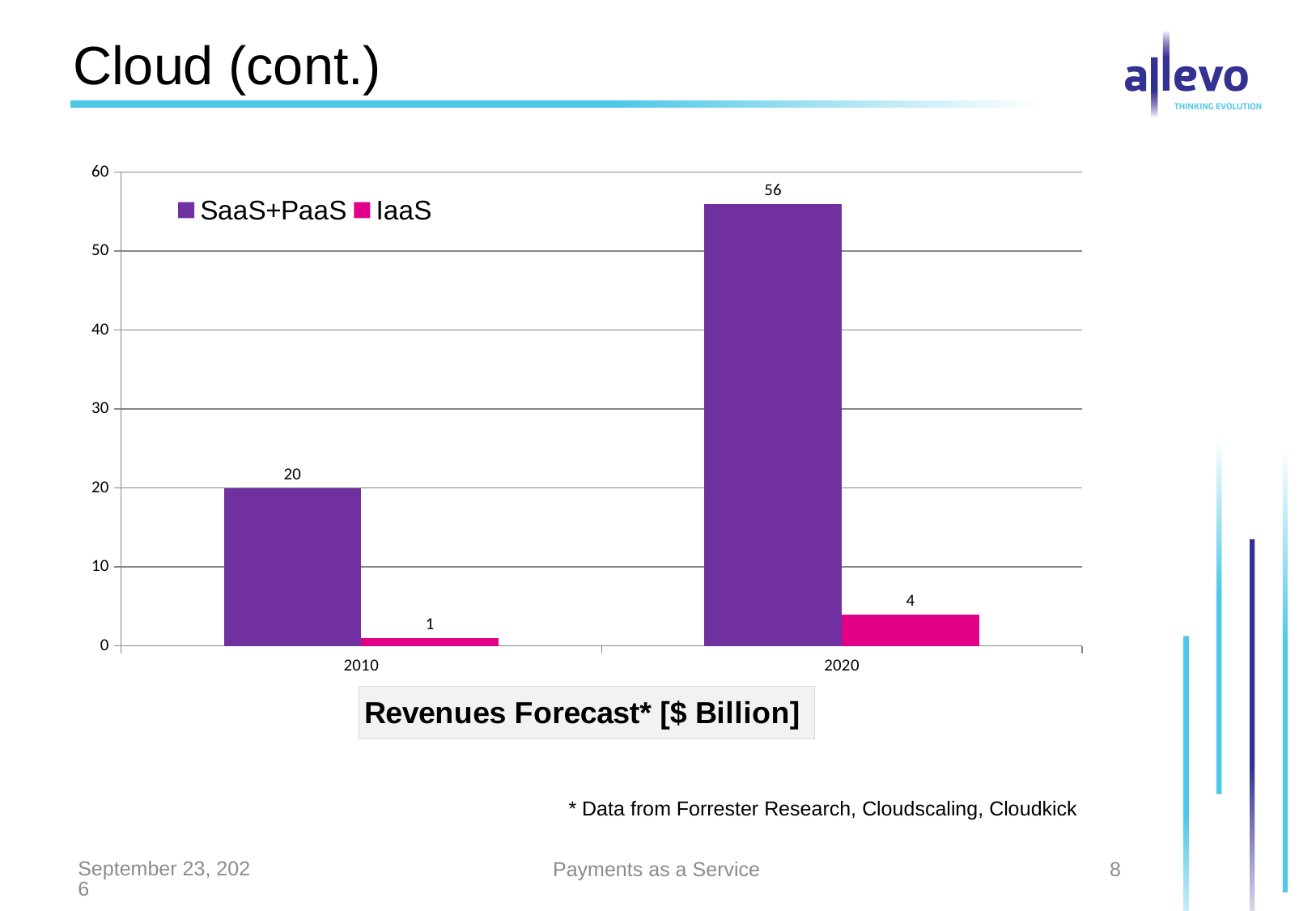
What is the SaaS+PaaS revenue forecast for 2010? 20 What is the IaaS revenue forecast for 2020? 4 What is the difference between the SaaS+PaaS values for 2020 and 2010? 36 What kind of chart is shown on the slide? Bar chart What is the SaaS+PaaS value for 2020? 56 How many years are shown on the x axis? 2 Which series has the lowest value in 2010? IaaS Which year has the highest SaaS+PaaS value? 2020 What is the IaaS value for 2010? 1 What is the title shown below the chart? Revenues Forecast* [$ Billion] How many series does the legend list? 2 Which is larger in 2020, SaaS+PaaS or IaaS? SaaS+PaaS